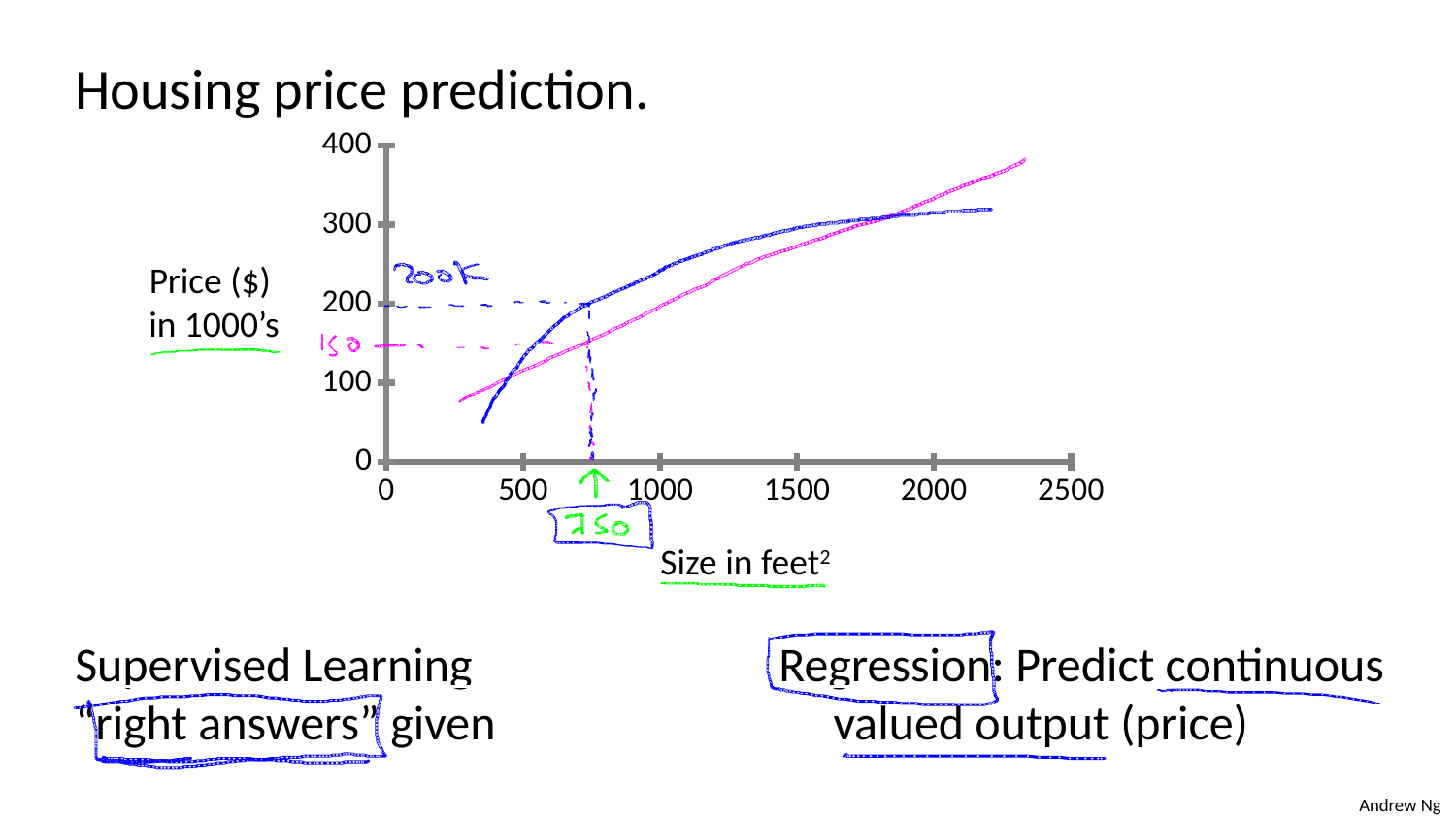
Do the plotted lines rise or fall as size in feet² increases? rise At a size of 2200, which line is higher, the blue line or the pink line? pink line According to the handwritten annotation, what price does the blue line give at a size of 750? 200K What is the label of the y axis of the chart? Price ($) in 1000's According to the handwritten annotation, what price does the pink line give at a size of 750? 150 Is the value of the pink line at a size of 2300 greater or less than 300? greater What is the title of the slide containing the chart? Housing price prediction. How many lines are plotted on the chart? 2 Is the value of the blue line at a size of 500 greater or less than 200? less At a size of 1000, which line is higher, the blue line or the pink line? blue line Is the value of the blue line at a size of 1500 greater or less than 200? greater What kind of chart is shown on the slide? line chart